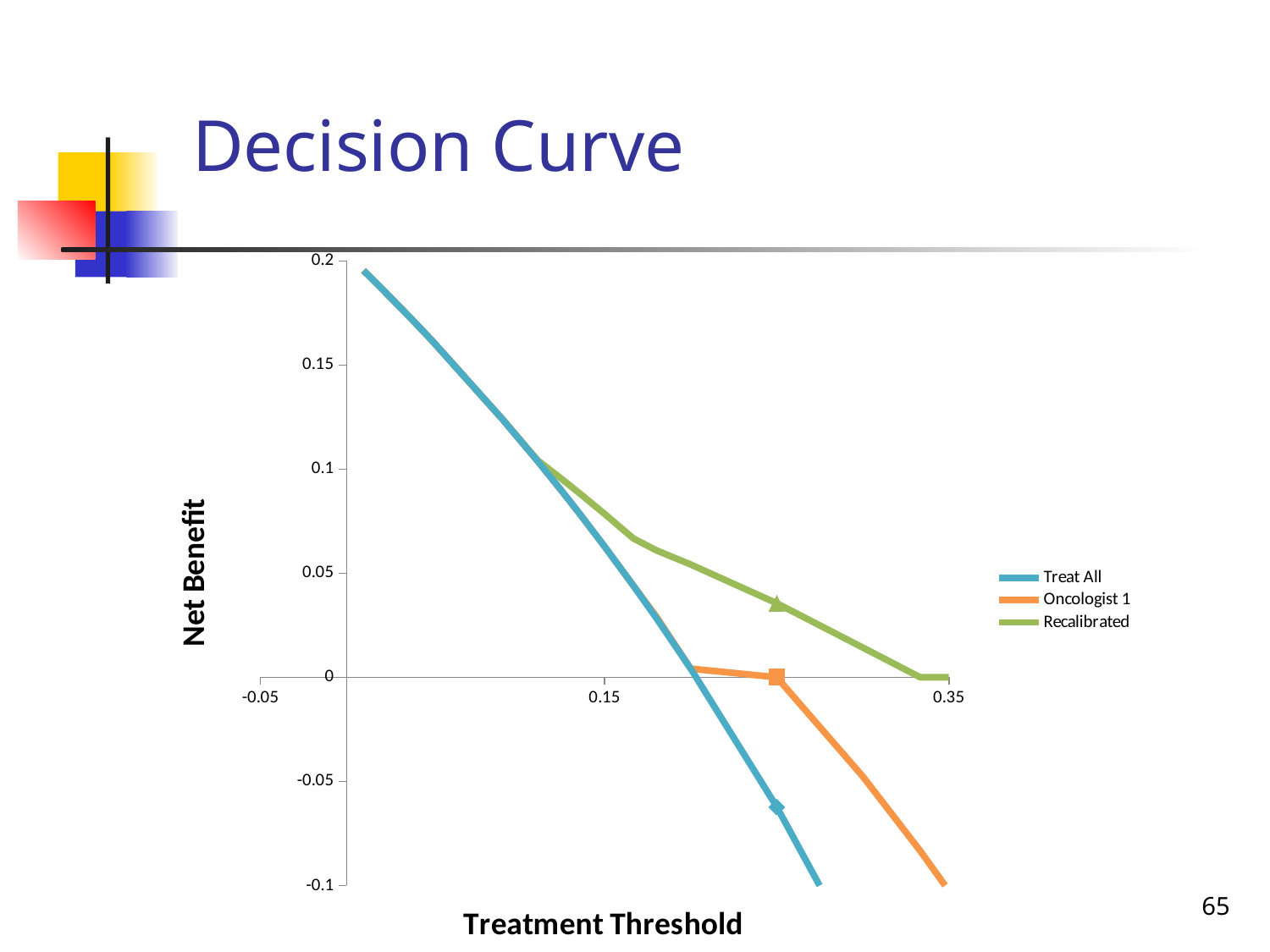
Which series has the lowest net benefit at a treatment threshold of 0.25? Treat All Is the net benefit for Oncologist 1 at a treatment threshold of 0.25 greater or less than 0.05? less What is the title of the chart? Decision Curve How many series does the legend list? 3 At a treatment threshold of 0.25, which series has the higher net benefit, Oncologist 1 or Treat All? Oncologist 1 Is the net benefit for Treat All at a treatment threshold of 0.25 greater or less than 0? less Does the Recalibrated line rise or fall as the treatment threshold increases? Fall Which series has the highest net benefit at a treatment threshold of 0.25? Recalibrated At a treatment threshold of 0.25, which series has the higher net benefit, Recalibrated or Oncologist 1? Recalibrated Does the Treat All line rise or fall as the treatment threshold increases? Fall What is the label of the vertical axis? Net Benefit What kind of chart is shown on the slide? Line chart